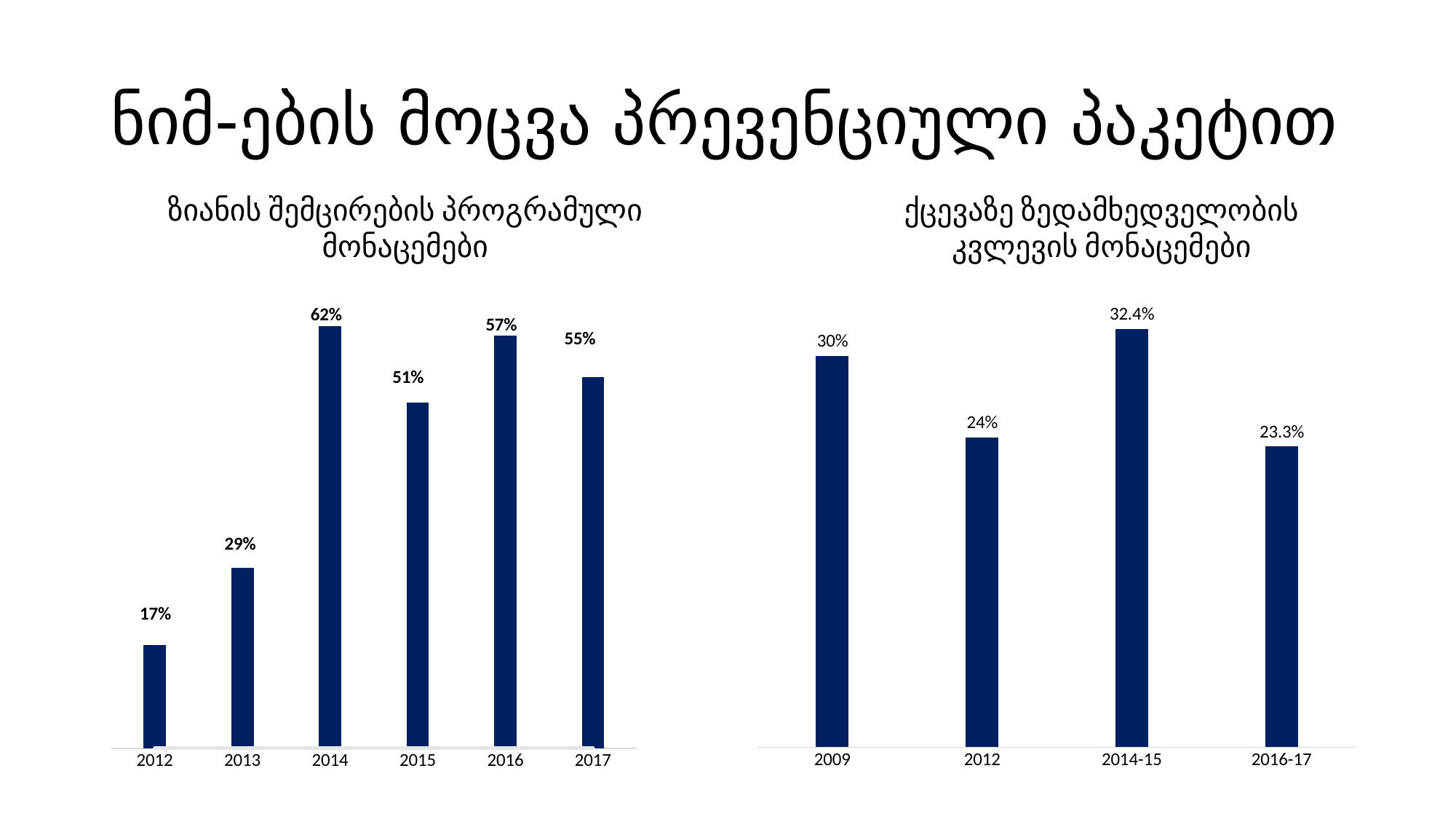
In the right chart, what is the difference between the values for 2009 and 2012? 6% In the right chart, what is the value for 2016-17? 23.3% In the left chart, what is the difference between the values for 2014 and 2012? 45% How many bars does the left chart have? 6 In the right chart, what is the value for 2014-15? 32.4% In the right chart, which period has the lowest value? 2016-17 What type of chart is the right chart? Bar chart In the left chart, which year has the highest value? 2014 How many bars does the right chart have? 4 In the left chart, what is the value for 2014? 62% In the left chart, what is the value for 2012? 17% In the left chart, which is larger, the value for 2016 or the value for 2017? 2016